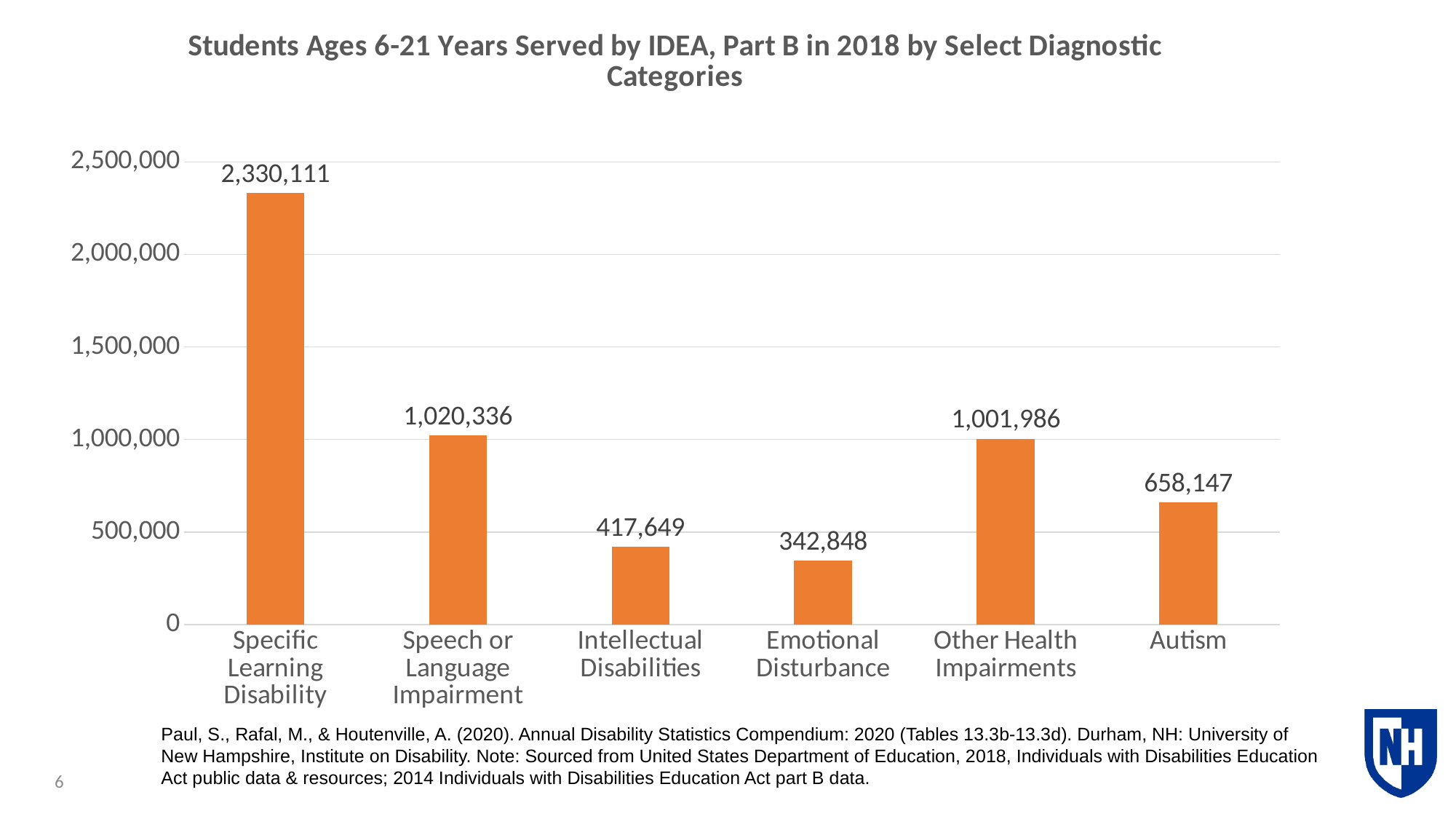
How many diagnostic categories are shown on the chart? 6 What is the value shown for Emotional Disturbance? 342,848 What is the difference between the values for Specific Learning Disability and Speech or Language Impairment? 1,309,775 What is the value shown for Autism? 658,147 What is the title of the chart? Students Ages 6-21 Years Served by IDEA, Part B in 2018 by Select Diagnostic Categories Which diagnostic category has the lowest number of students served? Emotional Disturbance Is the value for Other Health Impairments greater or less than 1,000,000? greater What is the difference between the values for Intellectual Disabilities and Emotional Disturbance? 74,801 What kind of chart is shown on the slide? Bar chart Which diagnostic category has the highest number of students served? Specific Learning Disability Which is larger, the value for Autism or the value for Intellectual Disabilities? Autism What is the number of students served for Specific Learning Disability? 2,330,111